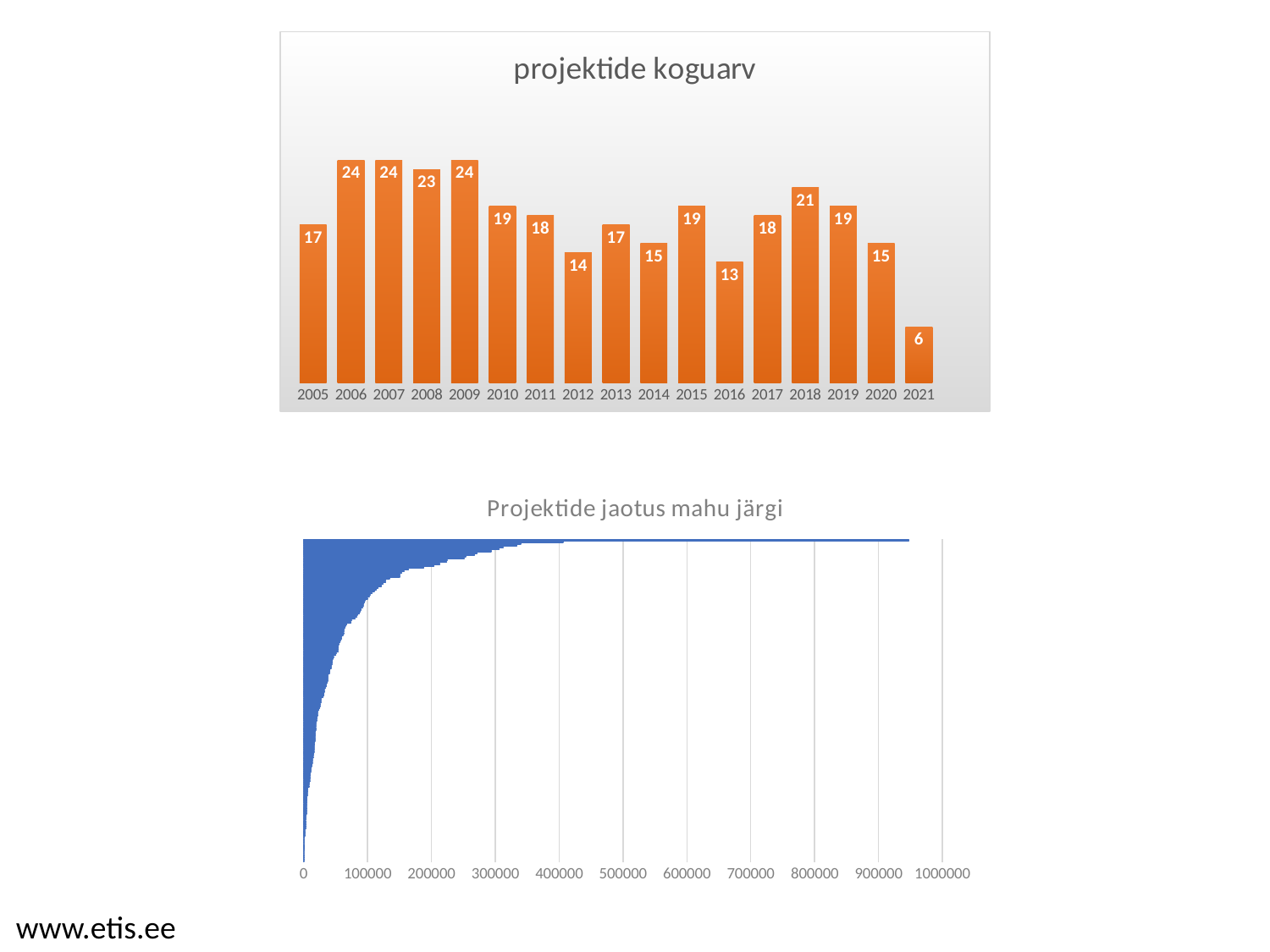
In the chart titled "projektide koguarv", do the values rise or fall from 2018 to 2021? fall In the chart titled "Projektide jaotus mahu järgi", is the longest bar greater or less than 900000? greater In the chart titled "projektide koguarv", what is the difference between the values for 2018 and 2021? 15 What kind of chart is the chart titled "projektide koguarv"? bar chart In the chart titled "projektide koguarv", what is the value for 2018? 21 In the chart titled "projektide koguarv", what is the highest value shown? 24 In the chart titled "projektide koguarv", what is the value for 2005? 17 In the chart titled "projektide koguarv", which is larger, the value for 2008 or the value for 2012? 2008 In the chart titled "projektide koguarv", which year has the lowest value? 2021 In the chart titled "projektide koguarv", how many years are shown on the x axis? 17 In the chart titled "projektide koguarv", what is the value for 2012? 14 What is the title of the lower chart on the slide? Projektide jaotus mahu järgi